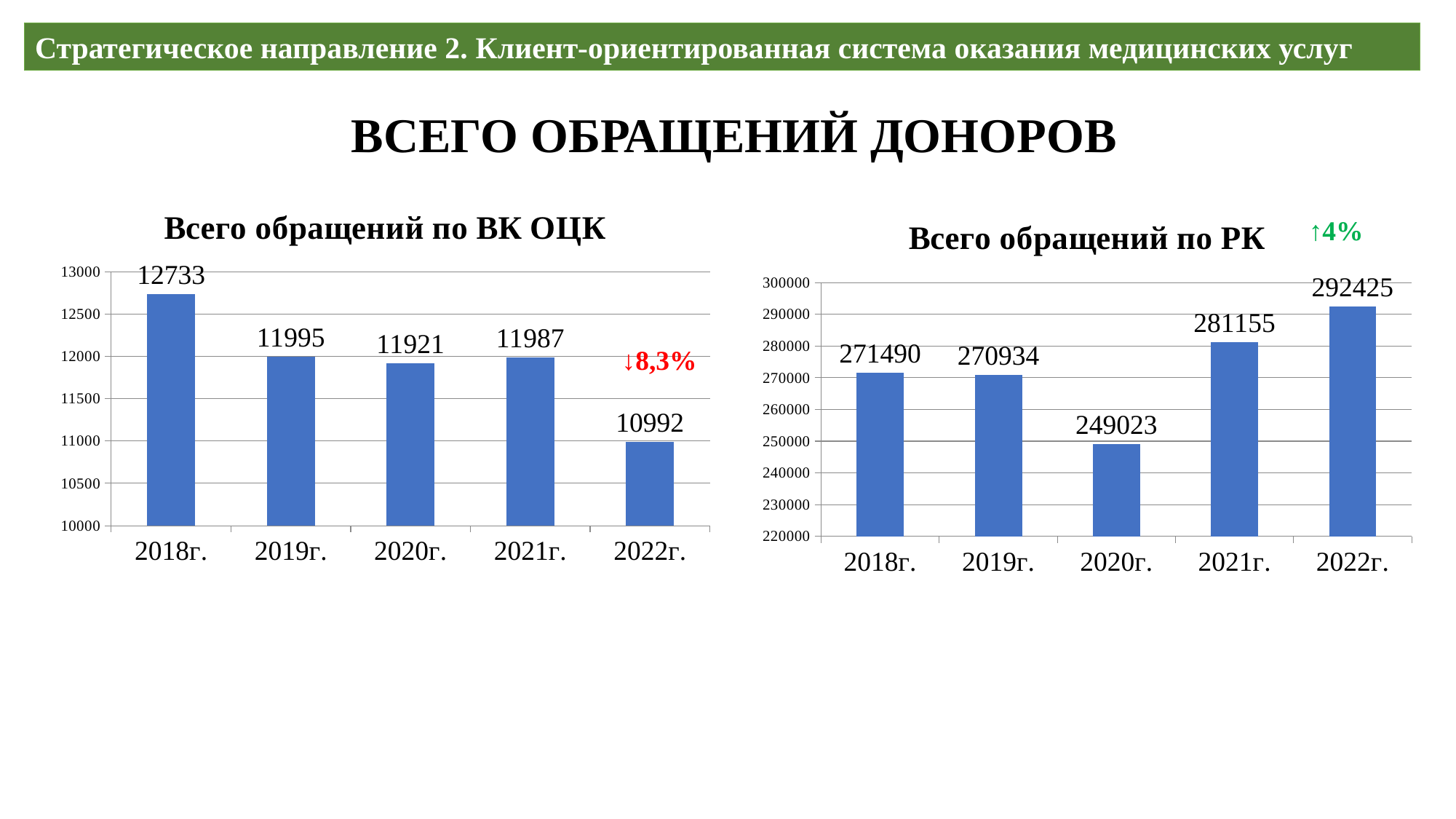
In the chart 'Всего обращений по ВК ОЦК', what is the value for 2022г.? 10992 In the chart 'Всего обращений по ВК ОЦК', which year has the highest value? 2018г. In the chart 'Всего обращений по РК', what is the value for 2022г.? 292425 In the chart 'Всего обращений по РК', which year has the lowest value? 2020г. What type of chart is 'Всего обращений по ВК ОЦК'? Bar chart In the chart 'Всего обращений по РК', which year has the highest value? 2022г. In the chart 'Всего обращений по РК', what is the value for 2020г.? 249023 In the chart 'Всего обращений по РК', how many years are shown on the x axis? 5 In the chart 'Всего обращений по ВК ОЦК', which year has the lowest value? 2022г. In the chart 'Всего обращений по РК', what is the difference between the values for 2022г. and 2021г.? 11270 In the chart 'Всего обращений по ВК ОЦК', what is the value for 2018г.? 12733 In the chart 'Всего обращений по ВК ОЦК', what is the difference between the values for 2021г. and 2022г.? 995